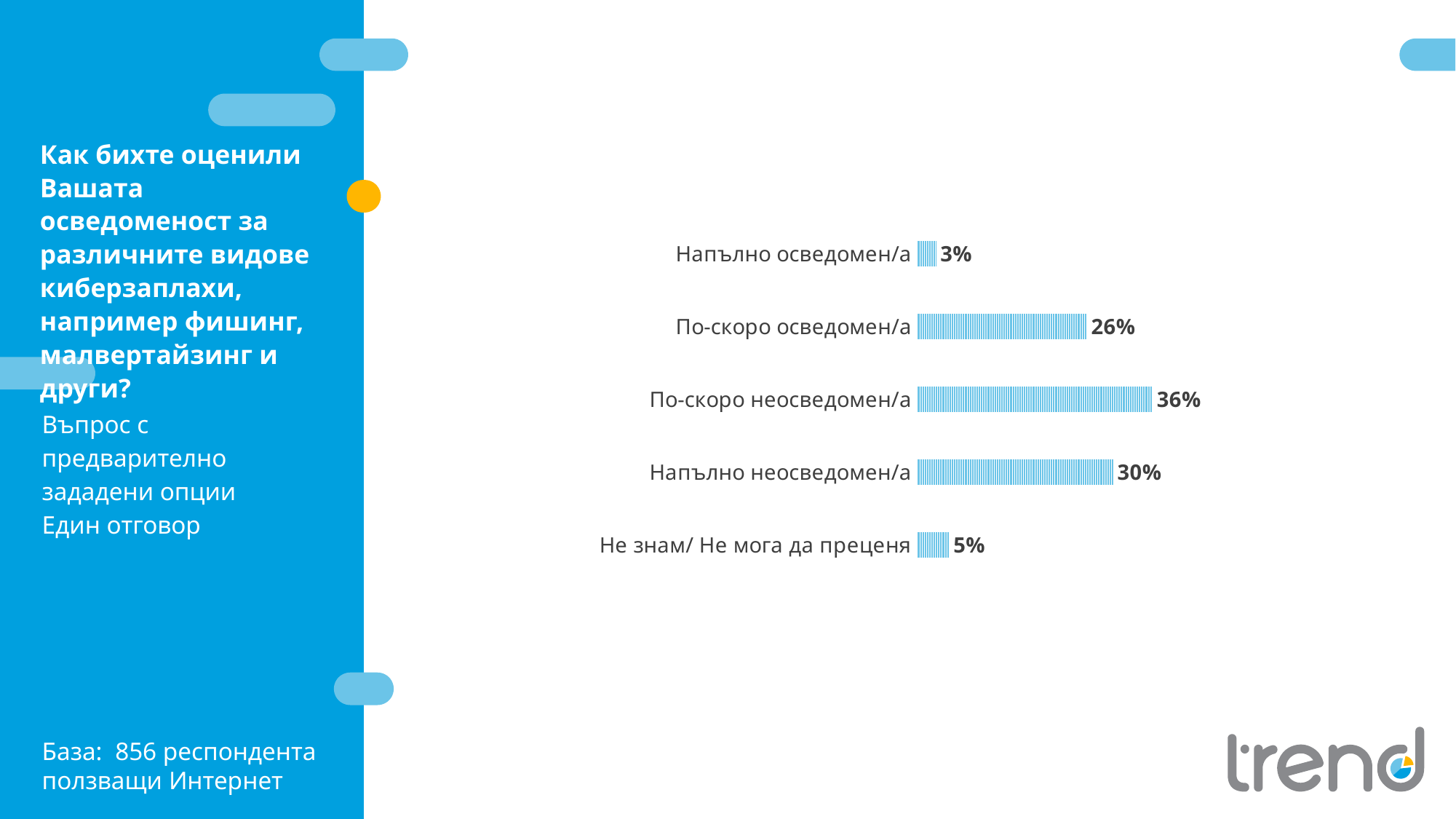
Which is larger: the value for "По-скоро осведомен/а" or the value for "Напълно неосведомен/а"? Напълно неосведомен/а What is the difference between the values for "По-скоро неосведомен/а" and "Напълно неосведомен/а"? 6% What is the value for "Напълно осведомен/а"? 3% What is the combined value of "Напълно осведомен/а" and "По-скоро осведомен/а"? 29% Which category has the highest value? По-скоро неосведомен/а Which category has the lowest value? Напълно осведомен/а What is the value for "По-скоро осведомен/а"? 26% What is the value for "Не знам/ Не мога да преценя"? 5% What is the value for "По-скоро неосведомен/а"? 36% How many respondents form the base of the survey shown on the slide? 856 How many categories are shown in the chart? 5 What kind of chart is shown on the slide? Bar chart